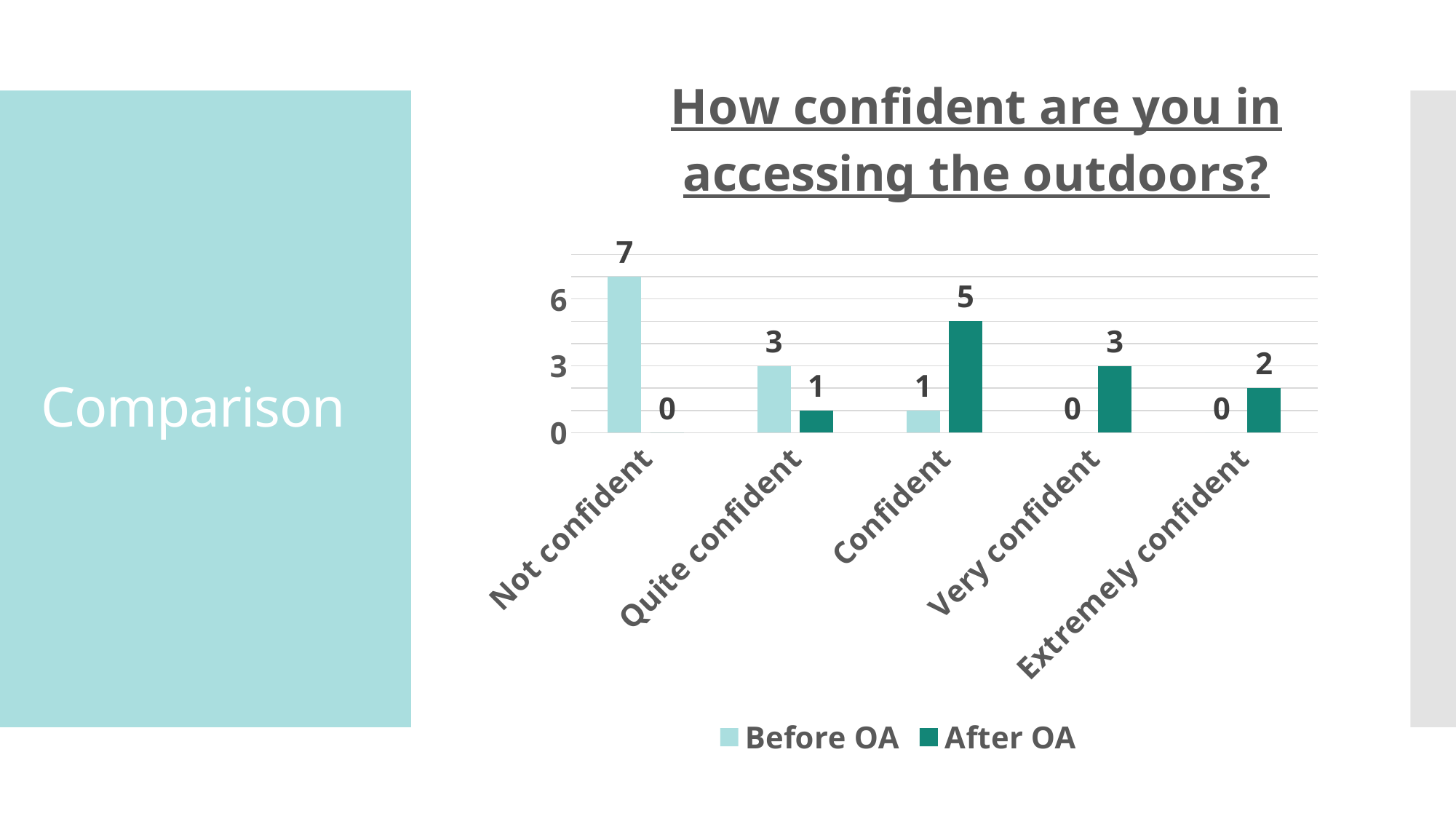
How many categories are shown on the x axis? 5 How many series does the legend list? 2 Which category has the highest After OA value? Confident What is the Before OA value for Very confident? 0 What is the After OA value for Confident? 5 What kind of chart is shown on the slide? Bar chart Which is larger for Confident: the Before OA value or the After OA value? After OA What is the difference between the Before OA and After OA values for Quite confident? 2 What is the After OA value for Extremely confident? 2 What is the title of the chart? How confident are you in accessing the outdoors? What is the Before OA value for Not confident? 7 Which category has the highest Before OA value? Not confident